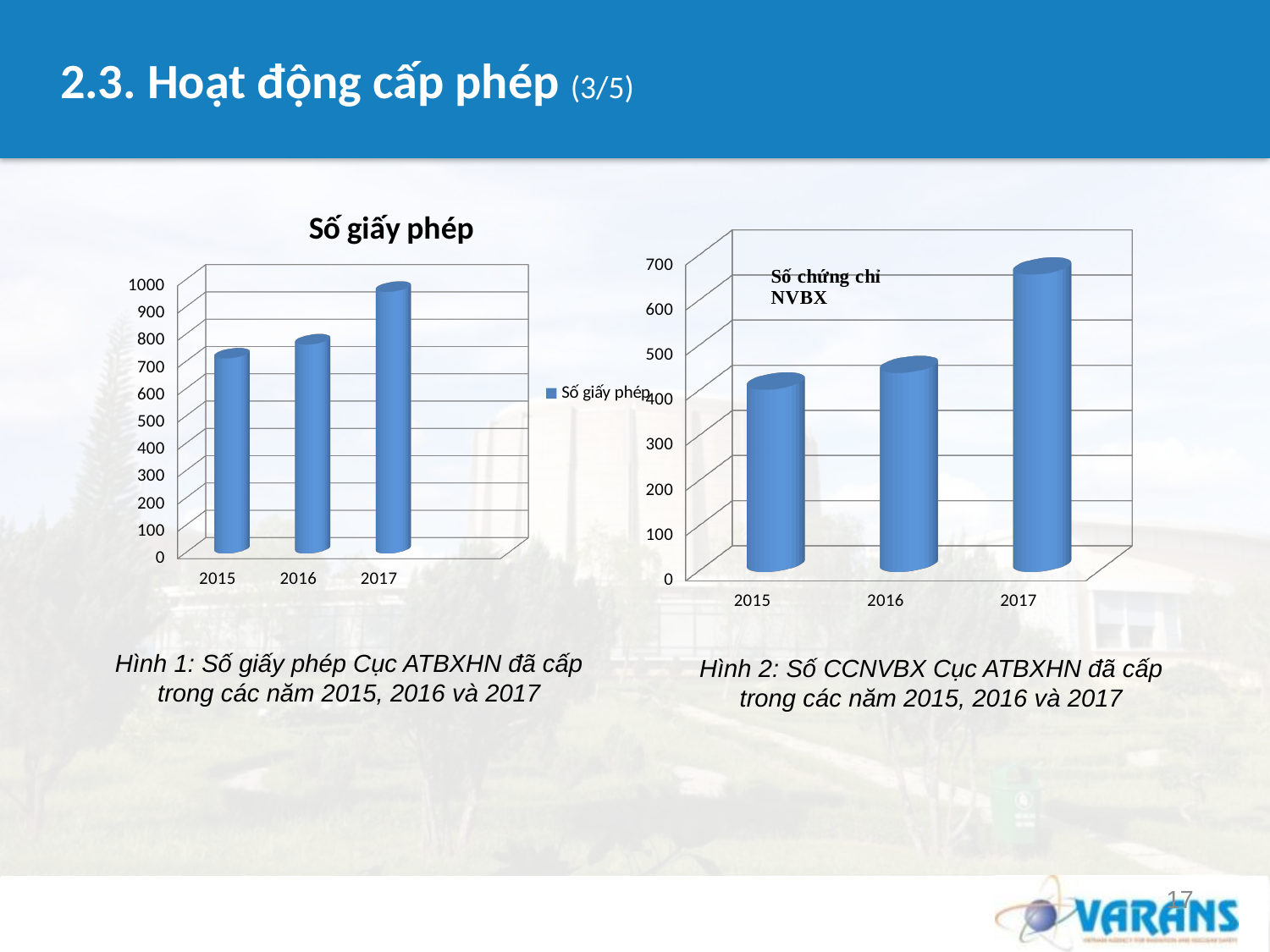
In the chart titled "Số chứng chỉ NVBX", is the value for 2015 greater or less than 500? less In the chart titled "Số giấy phép", which year has the lowest value? 2015 In the chart titled "Số giấy phép", how many years are shown on the x axis? 3 In the chart titled "Số giấy phép", is the value for 2017 greater or less than 900? greater In the chart titled "Số chứng chỉ NVBX", which year has the highest value? 2017 In the chart titled "Số giấy phép", is the value for 2016 greater or less than 800? less How many series does the legend of the chart titled "Số giấy phép" list? 1 In the chart titled "Số chứng chỉ NVBX", which is larger, the value for 2016 or the value for 2017? 2017 What kind of chart is the chart titled "Số giấy phép"? bar chart In the chart titled "Số giấy phép", do the values rise or fall from 2015 to 2017? rise In the chart titled "Số giấy phép", which year has the highest value? 2017